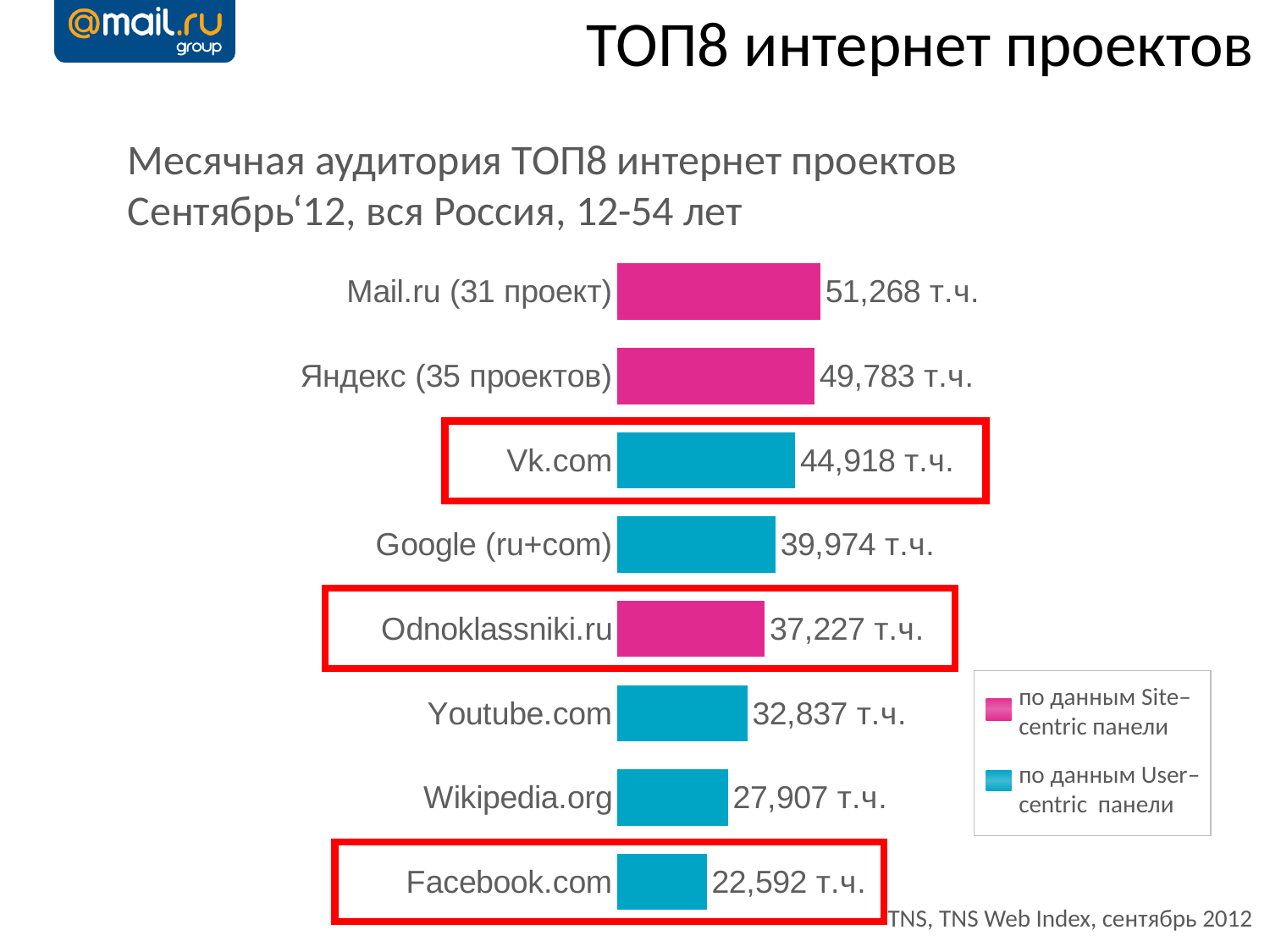
Which has a larger value, Google (ru+com) or Odnoklassniki.ru? Google (ru+com) Which project has the largest monthly audience on the chart? Mail.ru (31 проект) Which project has the smallest monthly audience on the chart? Facebook.com How many internet projects are shown on the chart? 8 What is the value shown for Facebook.com? 22,592 т.ч. What is the value shown for Vk.com? 44,918 т.ч. What is the difference between the values for Mail.ru (31 проект) and Яндекс (35 проектов)? 1,485 т.ч. What is the monthly audience value shown for Mail.ru (31 проект)? 51,268 т.ч. What is the value shown for Odnoklassniki.ru? 37,227 т.ч. What kind of chart is shown on the slide? Bar chart How many entries does the legend list? 2 What is the difference between the values for Youtube.com and Wikipedia.org? 4,930 т.ч.